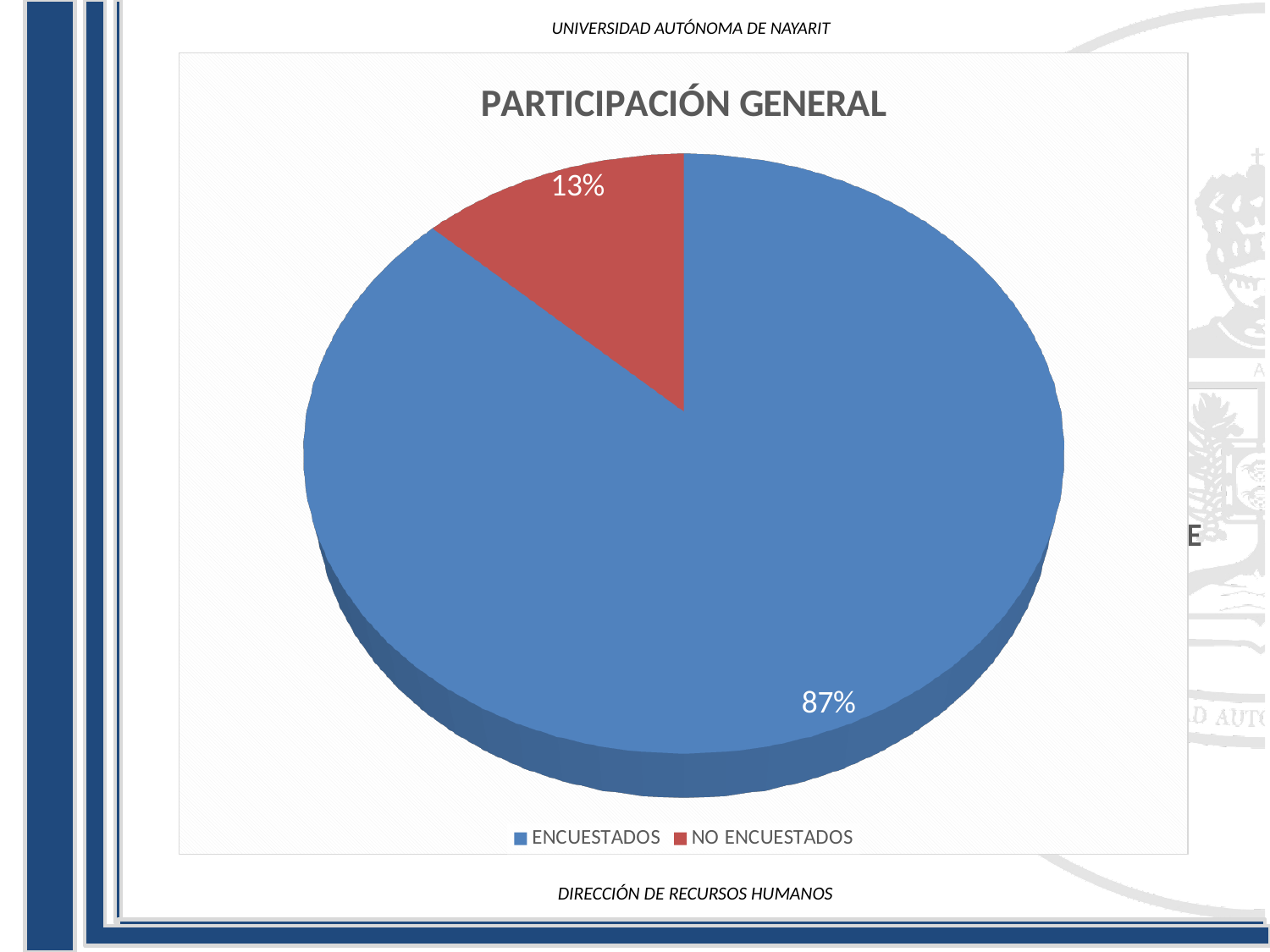
What colour is the slice for NO ENCUESTADOS? red Which category has the smallest slice of the pie? NO ENCUESTADOS Which is larger, the share for ENCUESTADOS or for NO ENCUESTADOS? ENCUESTADOS How many slices does the pie chart have? 2 What share of the pie does NO ENCUESTADOS represent? 13% How many categories does the legend list? 2 What kind of chart is shown on the slide? pie chart Which category has the largest slice of the pie? ENCUESTADOS What share of the pie does ENCUESTADOS represent? 87% What is the difference in percentage points between ENCUESTADOS and NO ENCUESTADOS? 74 What is the title of the chart? PARTICIPACIÓN GENERAL